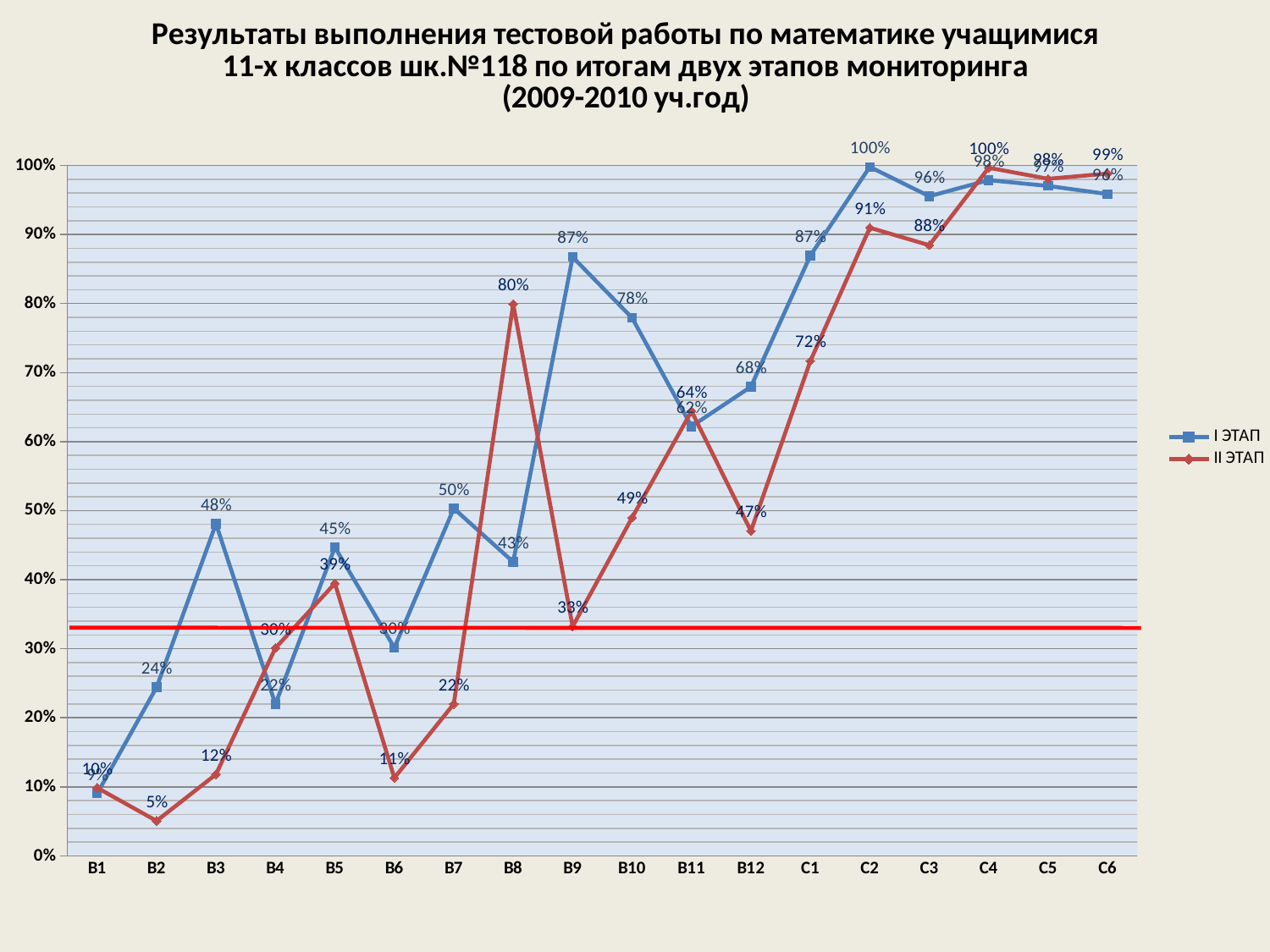
At which category is the II ЭТАП value lowest? B2 What is the value for II ЭТАП at C2? 91% What is the value for II ЭТАП at B8? 80% At B8, which series has the higher value, I ЭТАП or II ЭТАП? II ЭТАП What is the value for I ЭТАП at B12? 68% What is the value for I ЭТАП at B3? 48% What are the two entries listed in the legend? I ЭТАП and II ЭТАП How many series does the legend list? 2 What kind of chart is shown on the slide? line chart What is the difference between I ЭТАП and II ЭТАП at B12? 21 percentage points How many categories are shown along the x axis? 18 What is the difference between I ЭТАП and II ЭТАП at C1? 15 percentage points